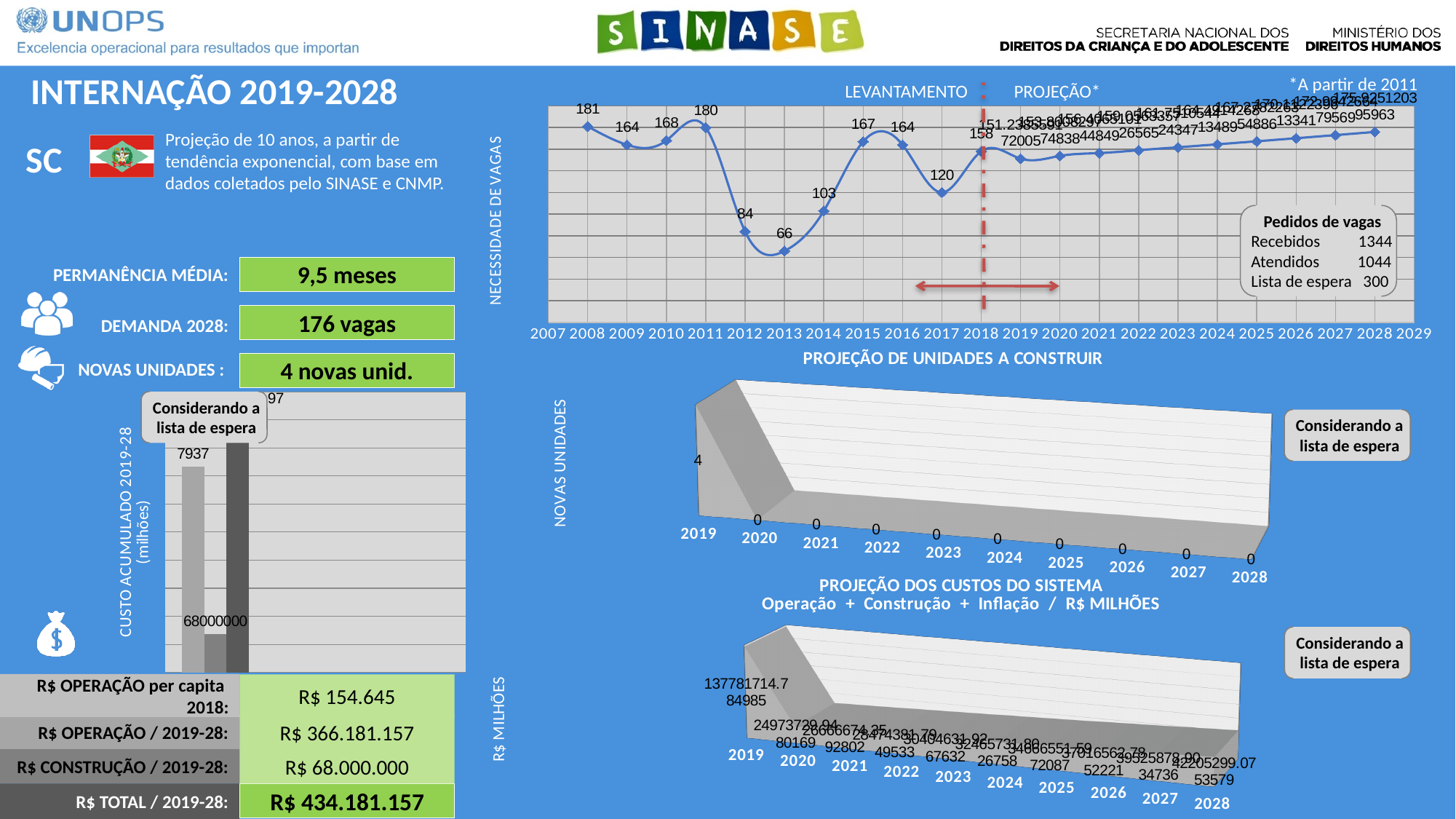
In the NECESSIDADE DE VAGAS line chart, which year between 2008 and 2018 has the lowest value? 2013 In the NECESSIDADE DE VAGAS line chart, what is the value for 2017? 120 How many years are shown on the x axis of the PROJEÇÃO DE UNIDADES A CONSTRUIR chart? 10 In the NECESSIDADE DE VAGAS line chart, do the values rise or fall from 2011 to 2013? fall In the PROJEÇÃO DE UNIDADES A CONSTRUIR chart, what is the value for 2024? 0 In the PROJEÇÃO DE UNIDADES A CONSTRUIR chart, what is the value for 2019? 4 In the NECESSIDADE DE VAGAS line chart, what is the value for 2013? 66 What kind of chart is the NECESSIDADE DE VAGAS chart at the top right? line chart In the NECESSIDADE DE VAGAS chart, what number of 'Recebidos' is shown in the 'Pedidos de vagas' box? 1344 In the NECESSIDADE DE VAGAS line chart, what is the value for 2008? 181 In the NECESSIDADE DE VAGAS line chart, what is the difference between the 2011 value and the 2012 value? 96 In the NECESSIDADE DE VAGAS line chart, which is larger, the value for 2015 or the value for 2016? 2015